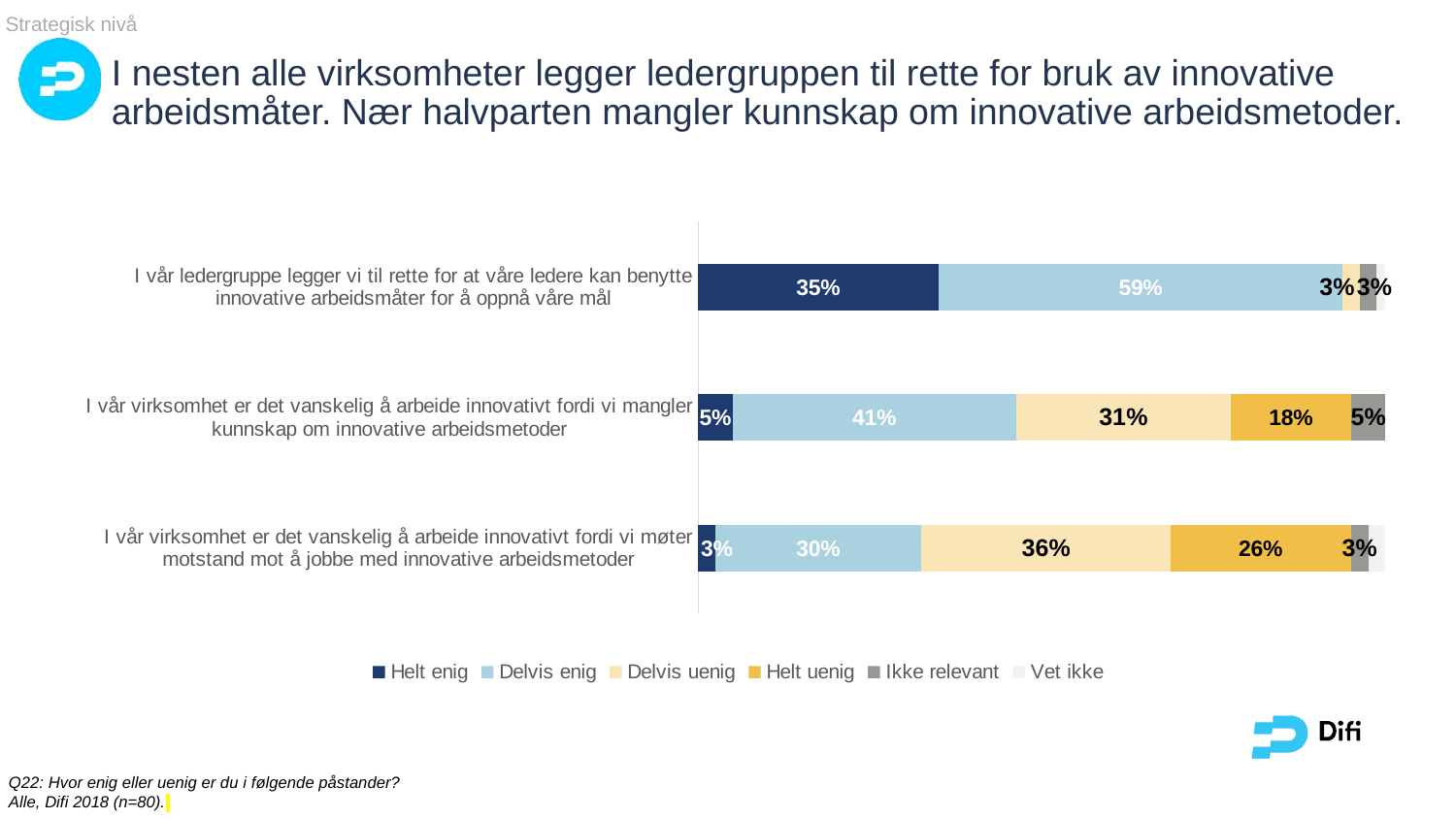
Which response category has the largest share for the statement about lacking knowledge ("mangler kunnskap") of innovative working methods? Delvis enig What percentage answered "Helt uenig" to "I vår virksomhet er det vanskelig å arbeide innovativt fordi vi møter motstand mot å jobbe med innovative arbeidsmetoder"? 26% What percentage answered "Delvis enig" to "I vår ledergruppe legger vi til rette for at våre ledere kan benytte innovative arbeidsmåter for å oppnå våre mål"? 59% What is the combined share of "Helt enig" and "Delvis enig" for the statement "I vår ledergruppe legger vi til rette for at våre ledere kan benytte innovative arbeidsmåter for å oppnå våre mål"? 94% What is the difference between the "Helt uenig" share for the statement about meeting resistance and the "Helt uenig" share for the statement about lacking knowledge? 8 percentage points How many statements are shown in the chart? 3 How many response categories does the legend list? 6 Which response category has the largest share for the statement about meeting resistance ("møter motstand") to innovative working methods? Delvis uenig What percentage answered "Helt enig" to "I vår ledergruppe legger vi til rette for at våre ledere kan benytte innovative arbeidsmåter for å oppnå våre mål"? 35% What type of chart is shown on the slide? Stacked bar chart What percentage answered "Delvis uenig" to "I vår virksomhet er det vanskelig å arbeide innovativt fordi vi mangler kunnskap om innovative arbeidsmetoder"? 31% Which is larger: the "Delvis enig" share for the statement about lacking knowledge, or the "Delvis enig" share for the statement about meeting resistance? The statement about lacking knowledge (41%)